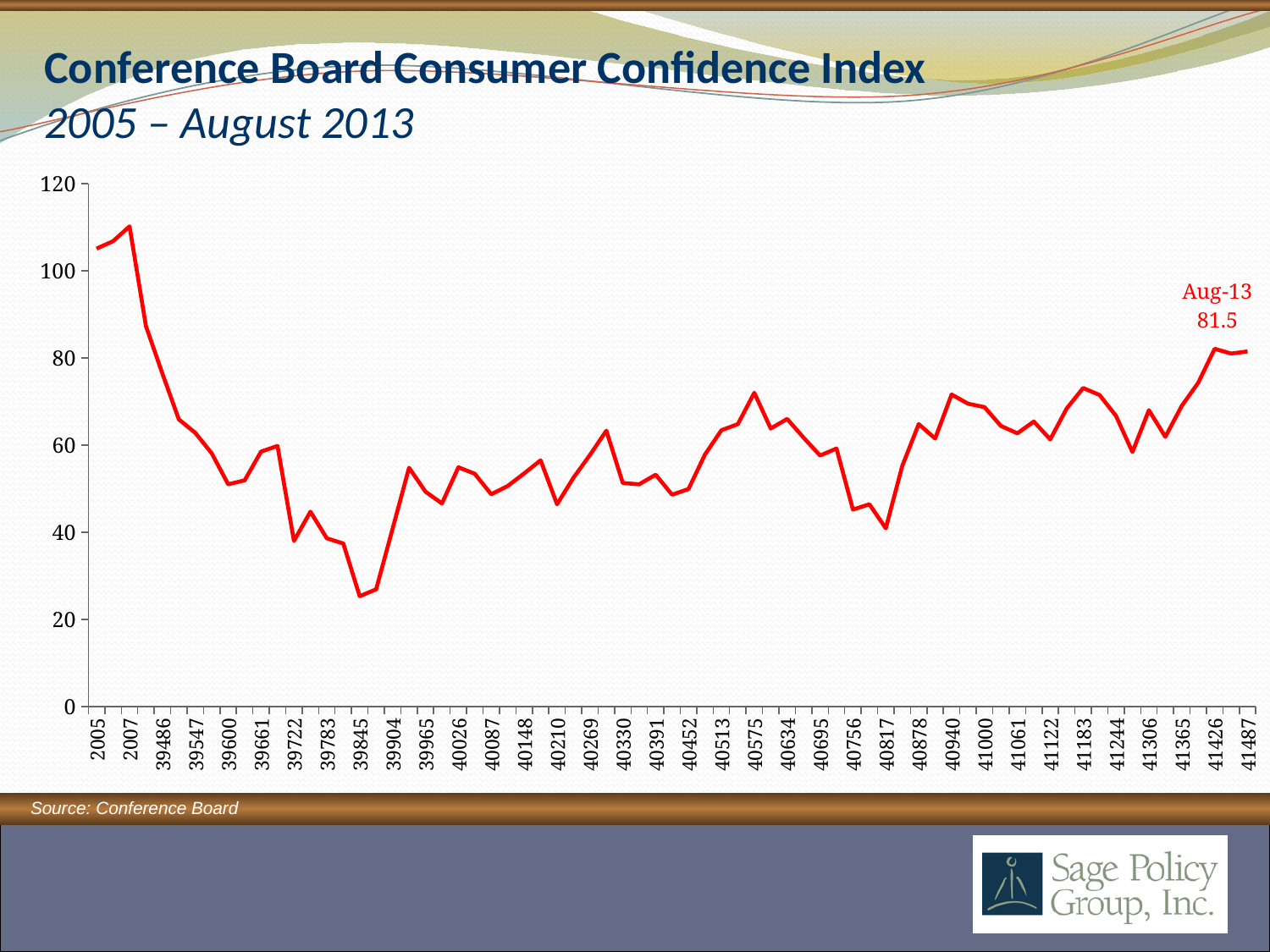
Is the value at 40575 greater or less than 60? greater Is the value for 2005 greater or less than 100? greater What is the title of the chart? Conference Board Consumer Confidence Index At which x-axis label does the line reach its lowest point? 39845 What kind of chart is shown on the slide? line chart Is the value at 39845 greater or less than 40? less What colour is the plotted line? red Do the values rise or fall between 2007 and 39845? fall Which is higher, the value for 2007 or the value for Aug-13? 2007 At which x-axis label does the line reach its highest point? 2007 What is the value of the Consumer Confidence Index labelled for Aug-13? 81.5